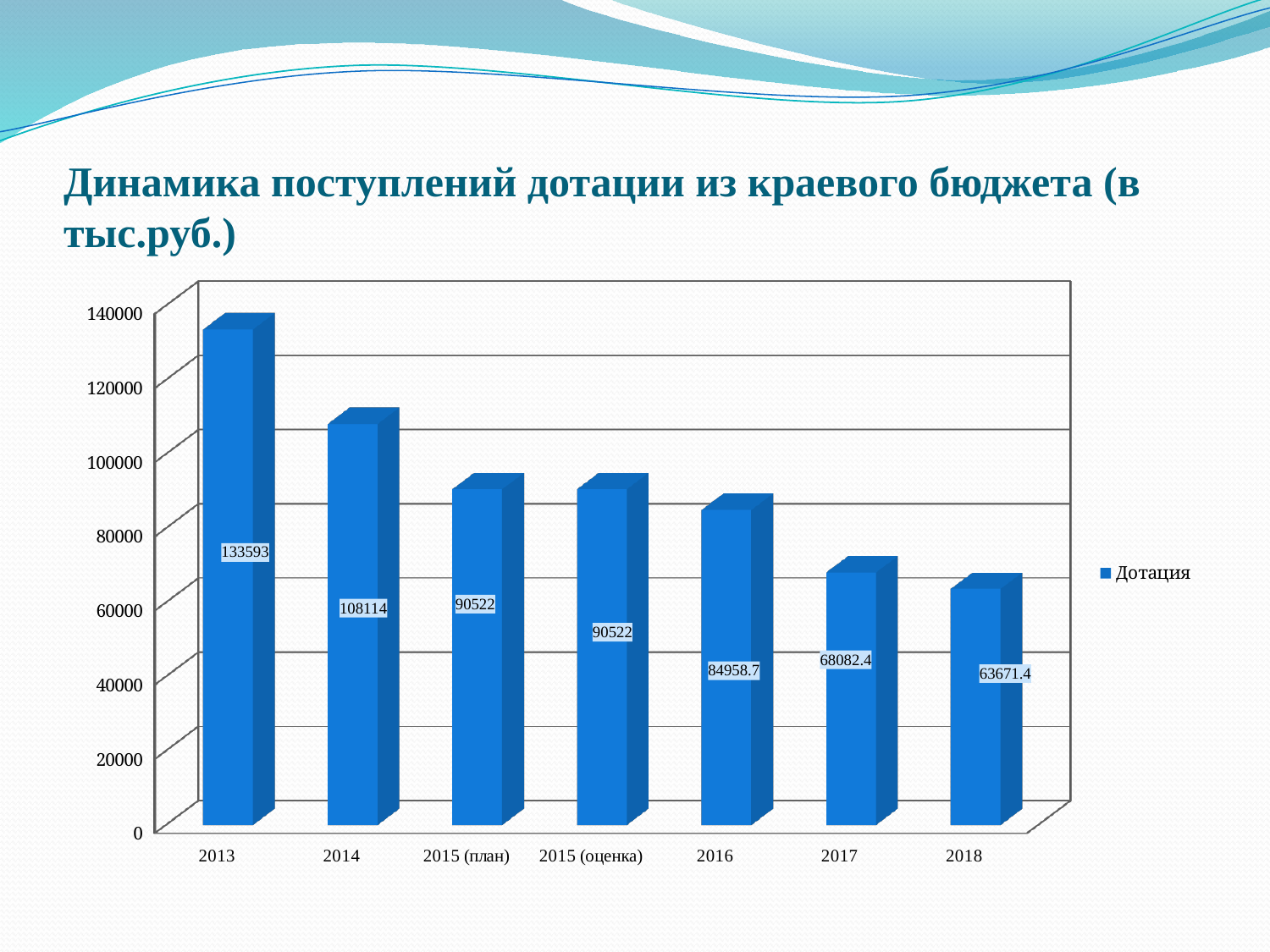
What kind of chart is shown on the slide? bar chart What is the difference between the values for 2017 and 2018? 4411 What is the difference between the values for 2013 and 2014? 25479 What is the value for 2018? 63671.4 Which year has the highest value? 2013 What is the value for 2015 (план)? 90522 Do the values rise or fall from 2013 to 2018? fall Which is larger, the value for 2014 or the value for 2016? 2014 How many categories are shown on the x axis? 7 What is the value for 2016? 84958.7 Which category has the lowest value? 2018 What is the value for 2013? 133593